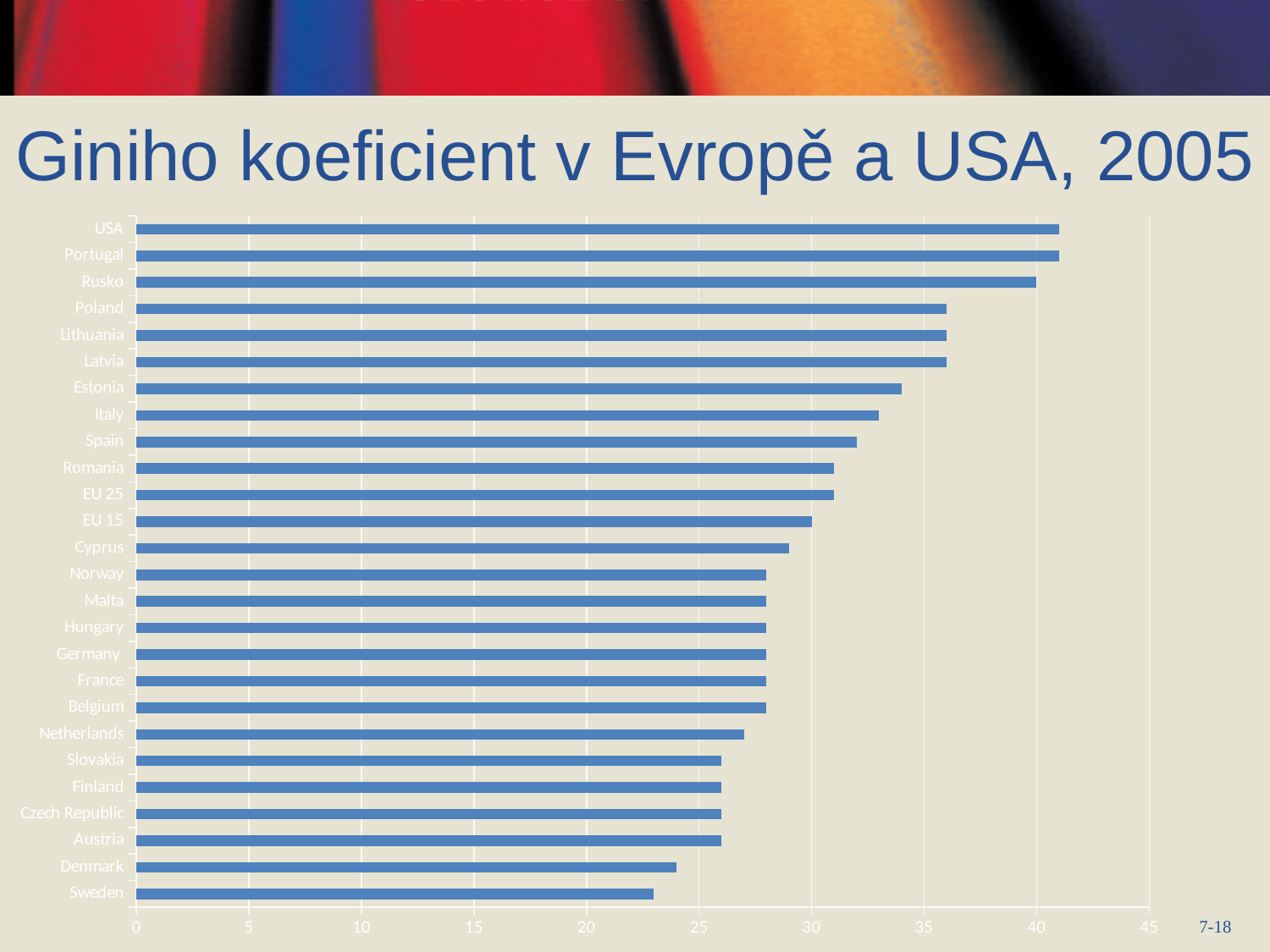
What kind of chart is shown on the slide? bar chart How many countries or regions are listed on the chart? 26 Do the bar values increase or decrease going from the top of the chart to the bottom? decrease Which has the larger value, Poland or Italy? Poland What is the title of the chart? Giniho koeficient v Evropě a USA, 2005 Is the value for Estonia greater or less than 35? less Which country has the lowest value on the chart? Sweden Which has the larger value, Denmark or Sweden? Denmark Is the value for USA greater or less than 40? greater Is the value for Spain greater or less than 30? greater